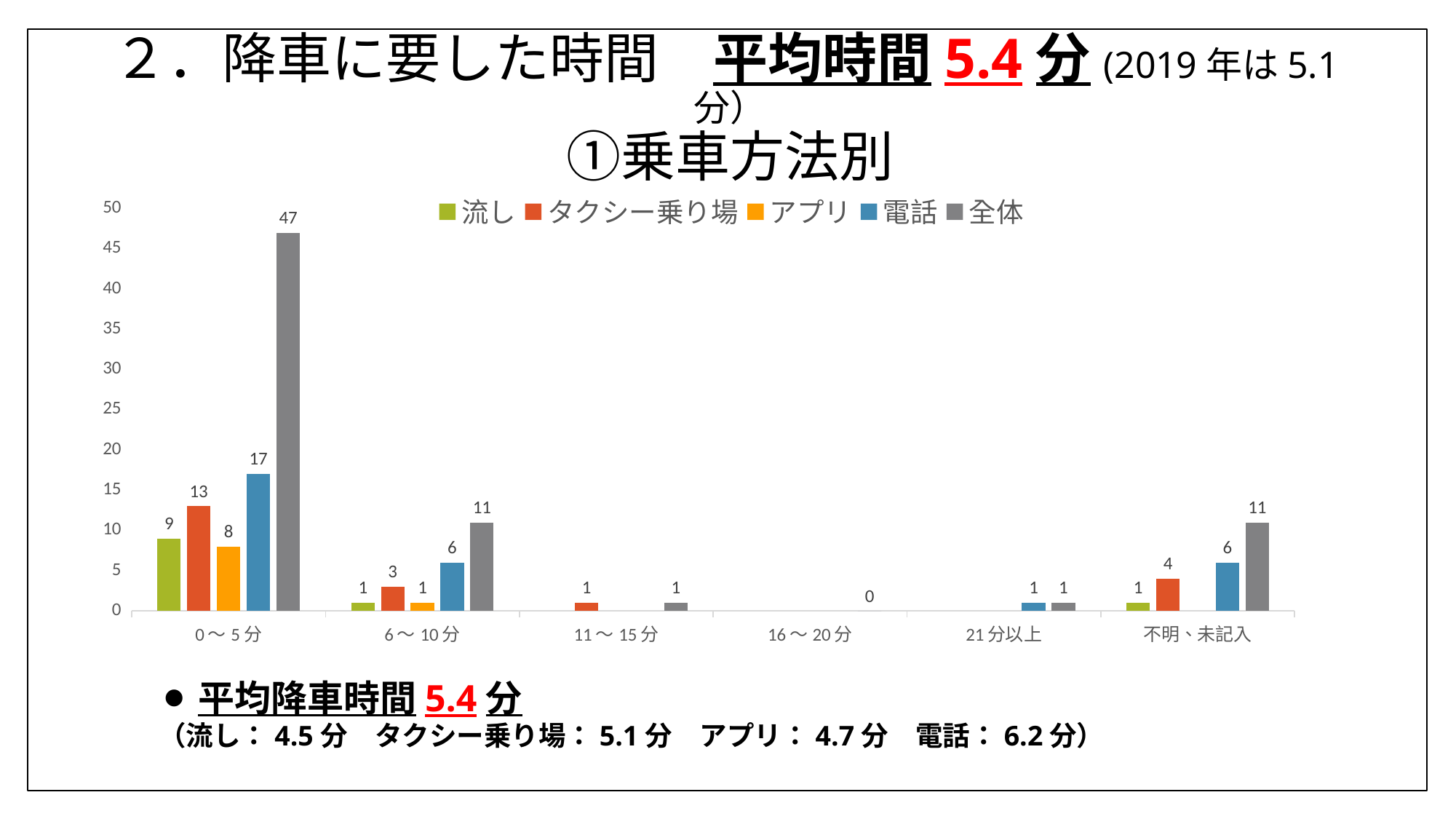
What is the title of the chart? ①乗車方法別 What is the difference between 全体 in 0～5分 and 全体 in 6～10分? 36 Which is larger in the 0～5分 category: タクシー乗り場 or 流し? タクシー乗り場 What is the value for 電話 in the 6～10分 category? 6 How many series does the legend list? 5 What is the value for 全体 in the 0～5分 category? 47 How many categories are shown on the x axis? 6 Which series has the lowest value in the 0～5分 category? アプリ What is the value for 電話 in the 0～5分 category? 17 Which category has the highest value for 全体? 0～5分 What is the value for タクシー乗り場 in the 不明、未記入 category? 4 What kind of chart is shown on the slide? bar chart